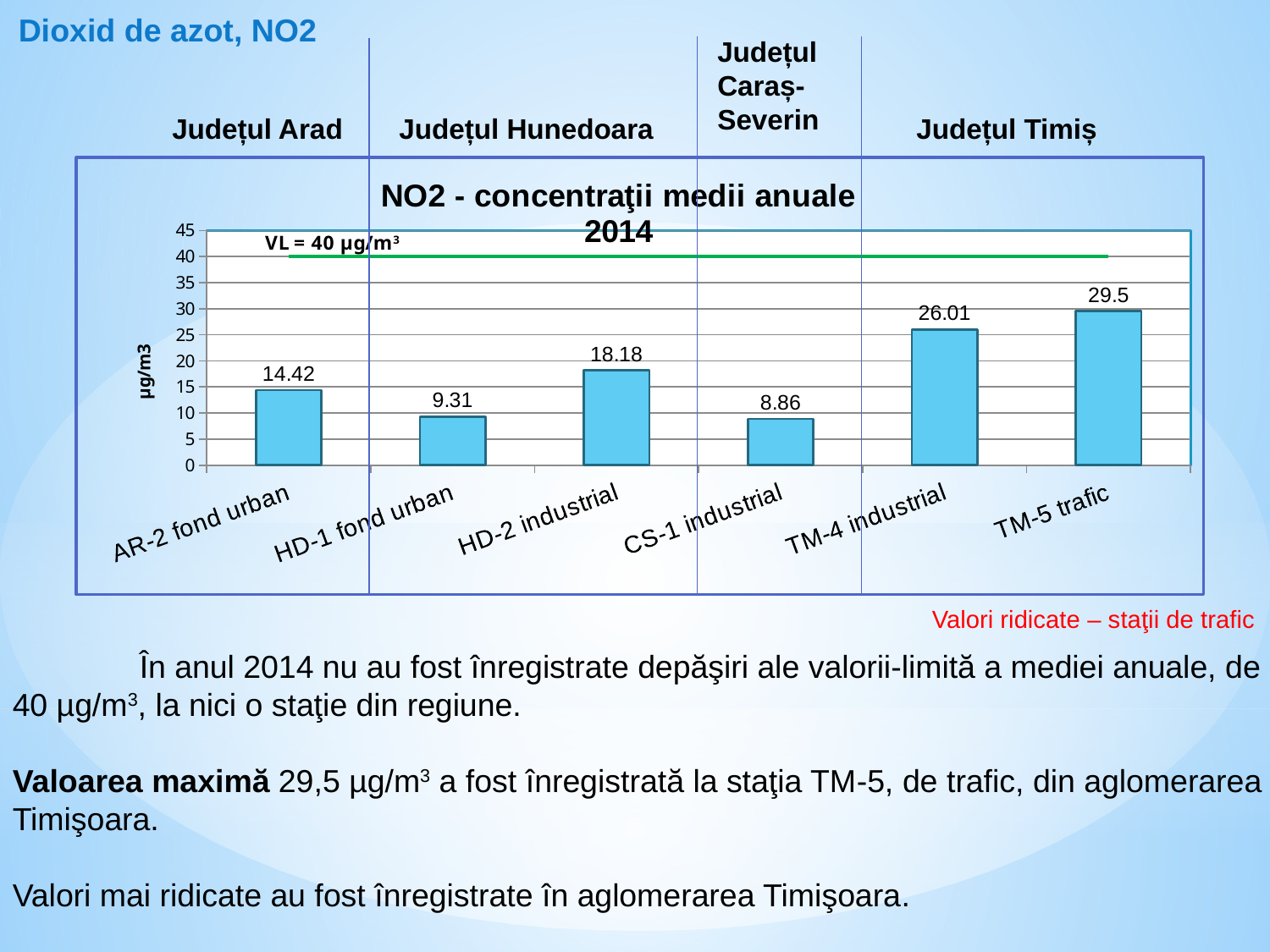
How many stations are plotted in the chart? 6 What is the value for HD-2 industrial? 18.18 What is the difference between the values for TM-5 trafic and TM-4 industrial? 3.49 Which is larger, the value for AR-2 fond urban or HD-2 industrial? HD-2 industrial What is the title of the chart? NO2 - concentraţii medii anuale 2014 What is the value for TM-4 industrial? 26.01 Which station has the highest value? TM-5 trafic What is the value for AR-2 fond urban? 14.42 What is the value for CS-1 industrial? 8.86 What kind of chart is shown? bar chart What is the value for HD-1 fond urban? 9.31 Which station has the lowest value? CS-1 industrial